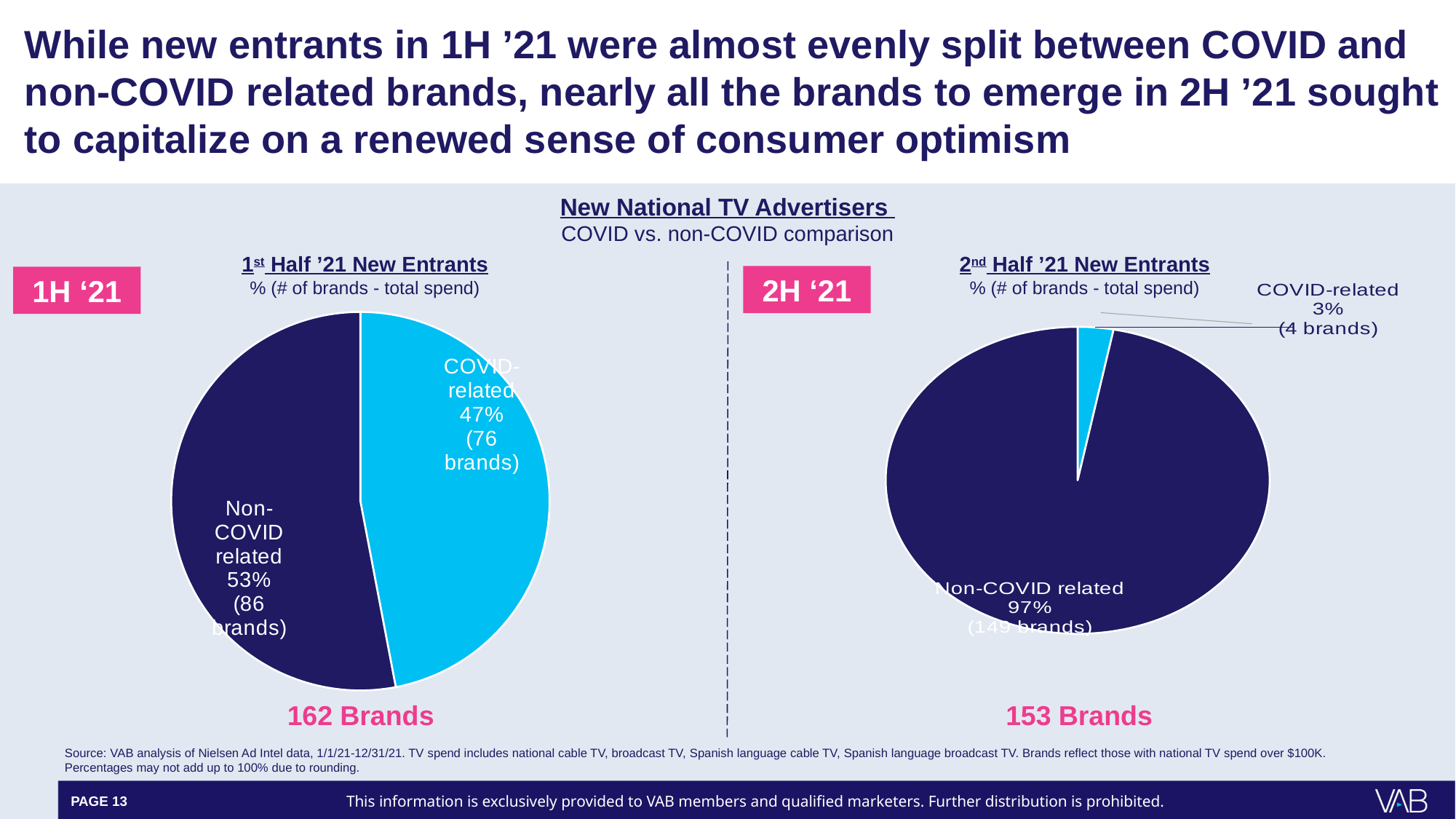
In the 2nd Half '21 New Entrants pie chart, which slice is the largest? Non-COVID related In the 2nd Half '21 New Entrants pie chart, what is the difference in number of brands between Non-COVID related and COVID-related? 145 brands How many slices does the 2nd Half '21 New Entrants pie chart have? 2 In the 1st Half '21 New Entrants pie chart, which slice is the smallest? COVID-related In the 1st Half '21 New Entrants pie chart, what is the difference in percentage points between Non-COVID related and COVID-related? 6 percentage points In the 2nd Half '21 New Entrants pie chart, what percentage is Non-COVID related? 97% What type of chart is used for the 1st Half '21 New Entrants? Pie chart In the 1st Half '21 New Entrants pie chart, what percentage is COVID-related? 47% What is the total number of brands shown below the 2nd Half '21 New Entrants pie chart? 153 Brands In the 2nd Half '21 New Entrants pie chart, how many brands are COVID-related? 4 brands Which chart has more COVID-related brands, the 1st Half '21 or the 2nd Half '21 pie chart? 1st Half '21 In the 1st Half '21 New Entrants pie chart, how many brands are Non-COVID related? 86 brands